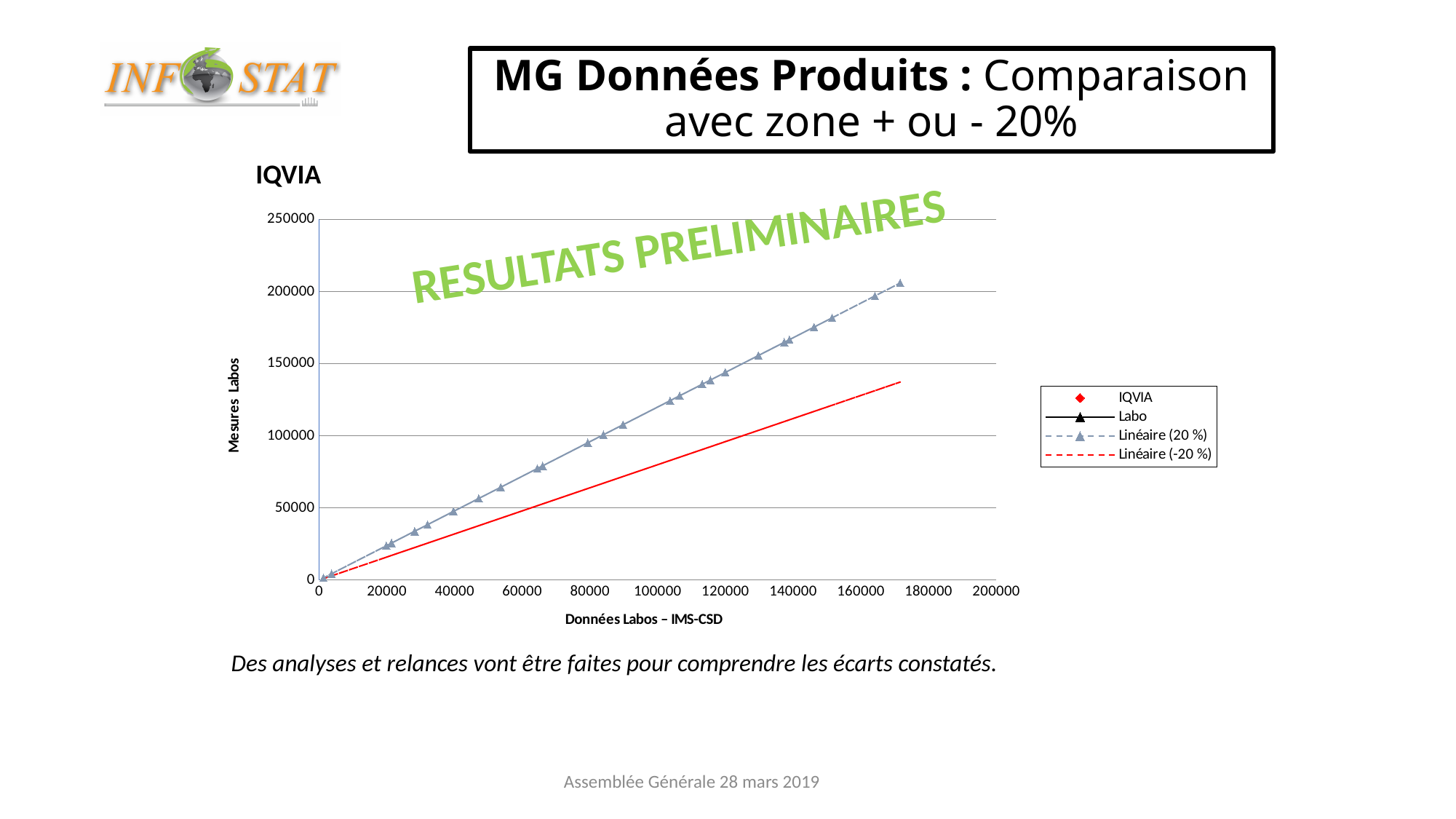
Which series is drawn as a red dashed line? Linéaire (-20 %) What kind of chart is shown on the slide? scatter chart with lines What is the highest value shown on the horizontal axis? 200000 Is the right-hand end of the red Linéaire (-20 %) line greater or less than 150000 on the vertical axis? less What is the title of the chart? IQVIA Is the highest plotted point of the Labo series greater or less than 150000 on the vertical axis? greater Do the plotted values rise or fall as the x-axis values increase? rise What is the label of the vertical axis? Mesures Labos How many series does the legend list? 4 At an x value of 100000, which line is higher: the Labo line or the Linéaire (-20 %) line? Labo What is the highest value shown on the vertical axis? 250000